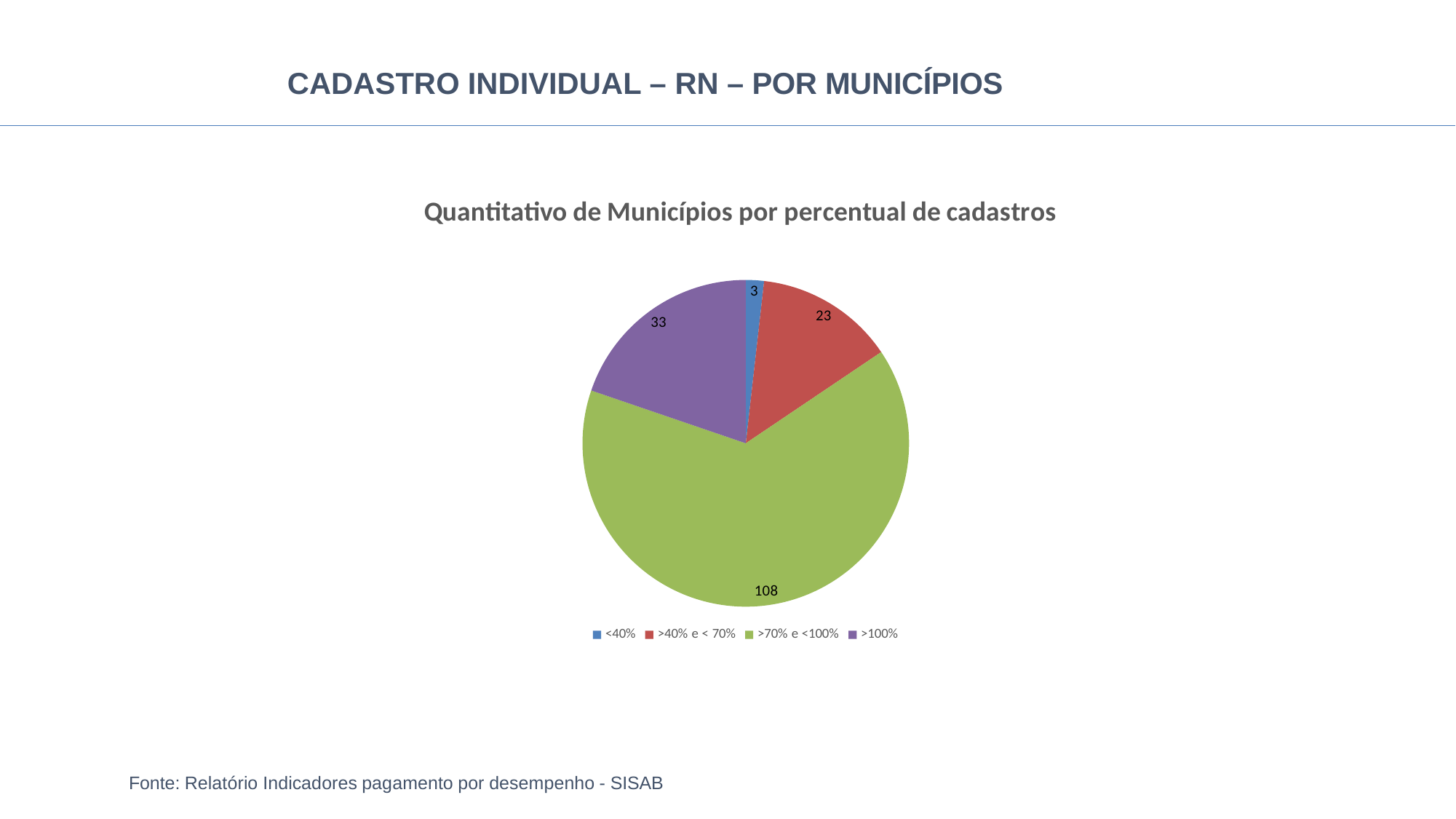
What kind of chart is shown on the slide? Pie chart What is the title of the chart? Quantitativo de Municípios por percentual de cadastros Which category has the largest number of municipalities? >70% e <100% Which category has the smallest number of municipalities? <40% Which is larger, the >100% category or the >40% e < 70% category? >100% How many municipalities are in the >100% category? 33 How many municipalities are in the >40% e < 70% category? 23 How many municipalities are in the >70% e <100% category? 108 What is the total number of municipalities across all slices of the pie? 167 How many municipalities are in the <40% category? 3 How many categories does the pie chart have? 4 What is the difference between the >100% and >40% e < 70% categories? 10